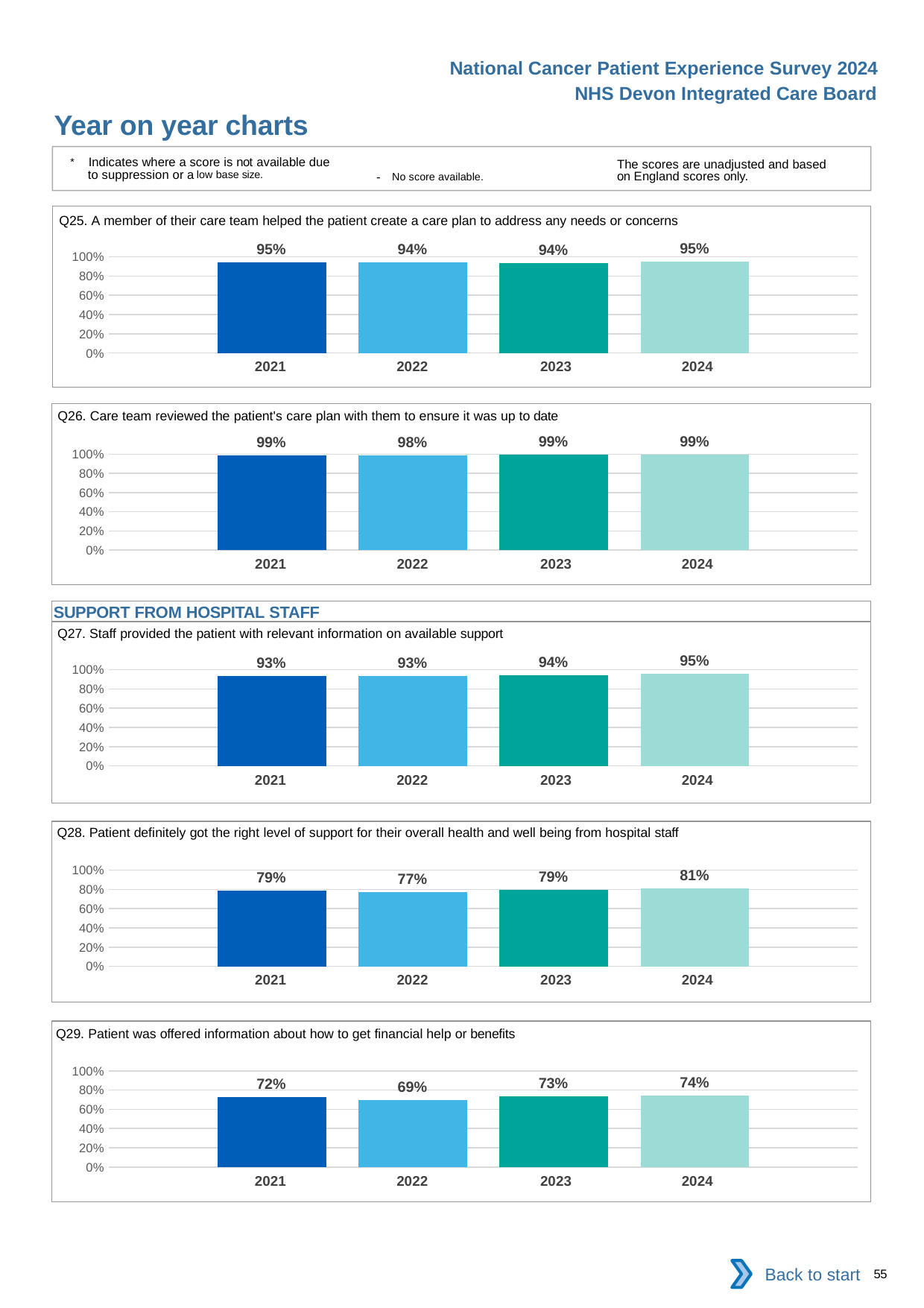
How many years are shown in the Q25 chart? 4 In the Q26 chart, what is the value for 2024? 99% In the Q28 chart, which year has the highest value? 2024 In the Q29 chart, is the value for 2023 larger or smaller than the value for 2022? larger What kind of chart is the Q27 chart? bar chart In the Q29 chart, what is the value for 2022? 69% In the Q28 chart, what is the difference between the 2024 and 2022 values? 4% In the Q25 chart, what is the value for 2021? 95% In the Q29 chart, is the value for 2021 greater or less than 80%? less In the Q27 chart, what is the difference between the 2024 and 2021 values? 2% In the Q26 chart, which year has the lowest value? 2022 In the Q27 chart, do the values rise or fall from 2022 to 2024? rise